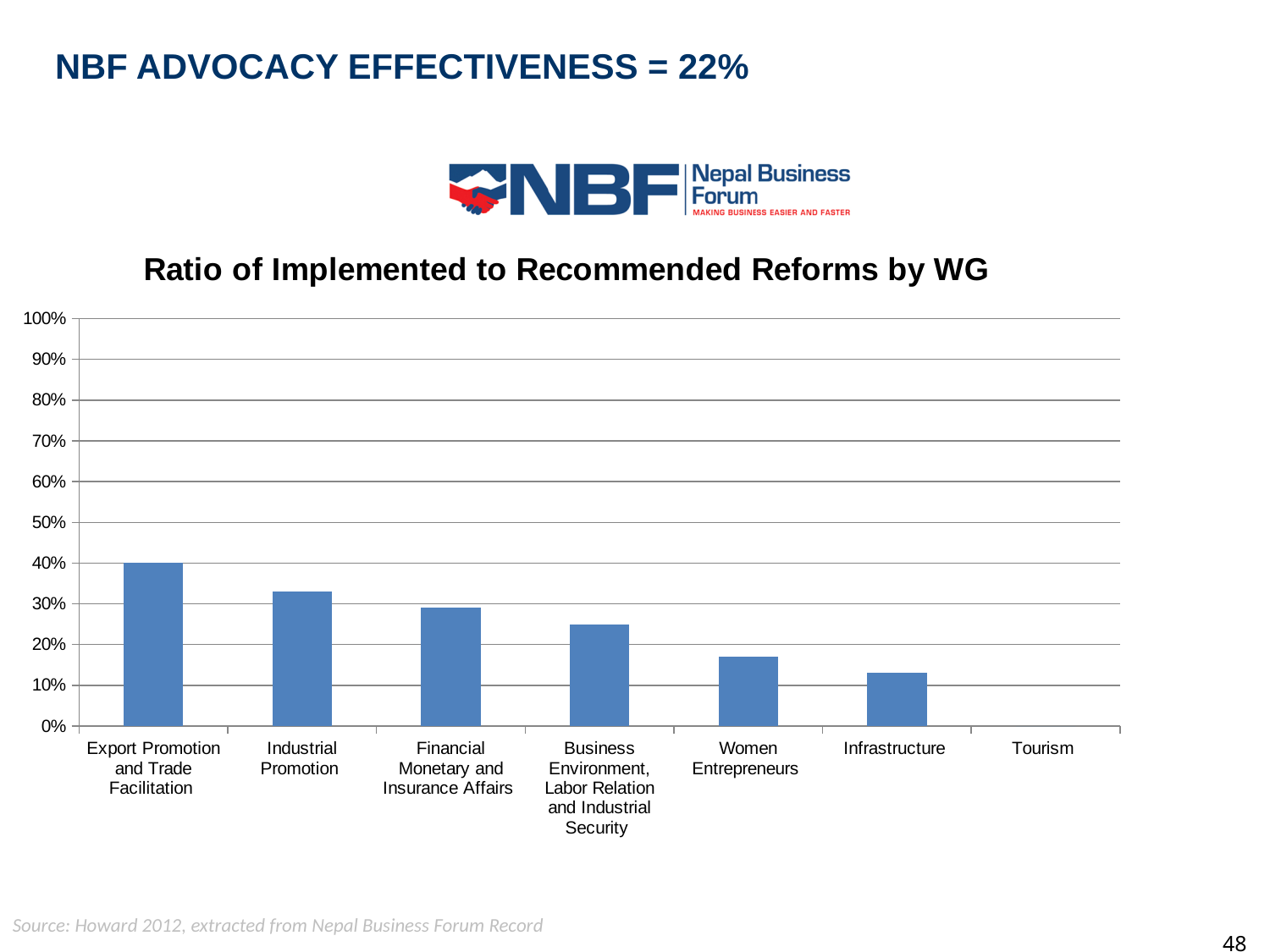
What is the value for Export Promotion and Trade Facilitation? 40% Which working group has the lowest ratio of implemented to recommended reforms? Tourism Is the value for Women Entrepreneurs greater or less than 20%? less Which working group has the highest ratio of implemented to recommended reforms? Export Promotion and Trade Facilitation Which is larger, the value for Industrial Promotion or the value for Infrastructure? Industrial Promotion What is the title of the chart? Ratio of Implemented to Recommended Reforms by WG How many working groups (categories) are shown on the x axis of the chart? 7 What is the value for Tourism? 0% What kind of chart is shown on the slide? bar chart Do the values rise or fall moving from left to right along the x axis? fall Is the value for Industrial Promotion greater or less than 30%? greater